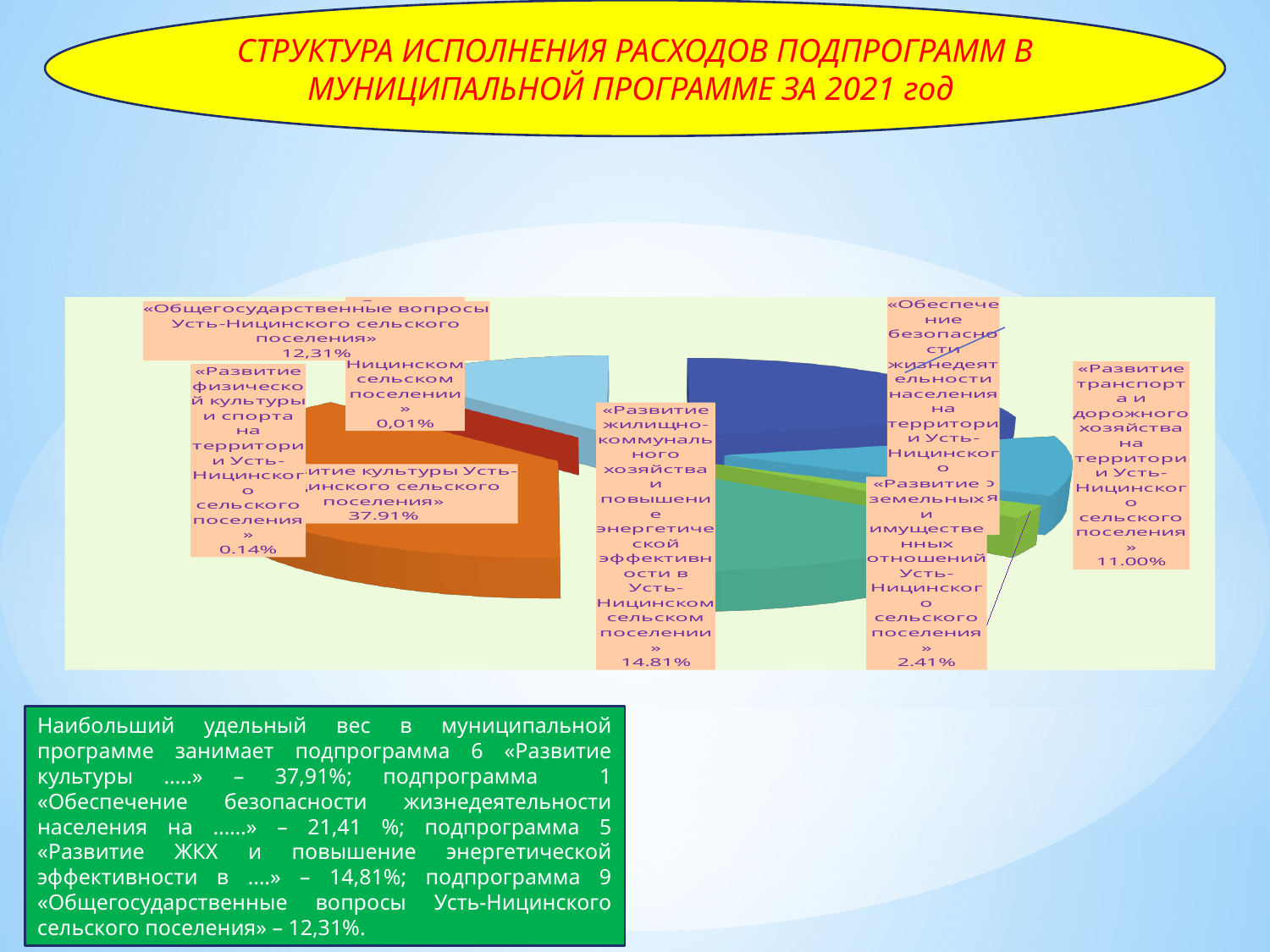
What type of chart is shown on the slide? pie chart What is the title of the slide containing the pie chart? СТРУКТУРА ИСПОЛНЕНИЯ РАСХОДОВ ПОДПРОГРАММ В МУНИЦИПАЛЬНОЙ ПРОГРАММЕ ЗА 2021 год What share does «Развитие транспорта и дорожного хозяйства на территории Усть-Ницинского сельского поселения» have in the pie chart? 11.00% What share does «Развитие жилищно-коммунального хозяйства и повышение энергетической эффективности в Усть-Ницинском сельском поселении» have in the pie chart? 14.81% Which has the larger share: «Развитие жилищно-коммунального хозяйства...» or «Развитие транспорта и дорожного хозяйства...»? «Развитие жилищно-коммунального хозяйства...» Which subprogram has the largest share in the pie chart? «Развитие культуры Усть-Ницинского сельского поселения» (37.91%) By how many percentage points does the share of «Развитие жилищно-коммунального хозяйства...» (14.81%) exceed that of «Развитие транспорта и дорожного хозяйства...» (11.00%)? 3.81 What share does «Развитие физической культуры и спорта на территории Усть-Ницинского сельского поселения» have in the pie chart? 0.14% What share does «Общегосударственные вопросы Усть-Ницинского сельского поселения» have in the pie chart? 12,31% What share does «Развитие земельных и имущественных отношений Усть-Ницинского сельского поселения» have in the pie chart? 2.41% By how many percentage points does the share of «Развитие культуры...» (37.91%) exceed that of «Общегосударственные вопросы...» (12,31%)? 25.60 Which has the larger share: «Развитие земельных и имущественных отношений...» or «Развитие физической культуры и спорта...»? «Развитие земельных и имущественных отношений...»